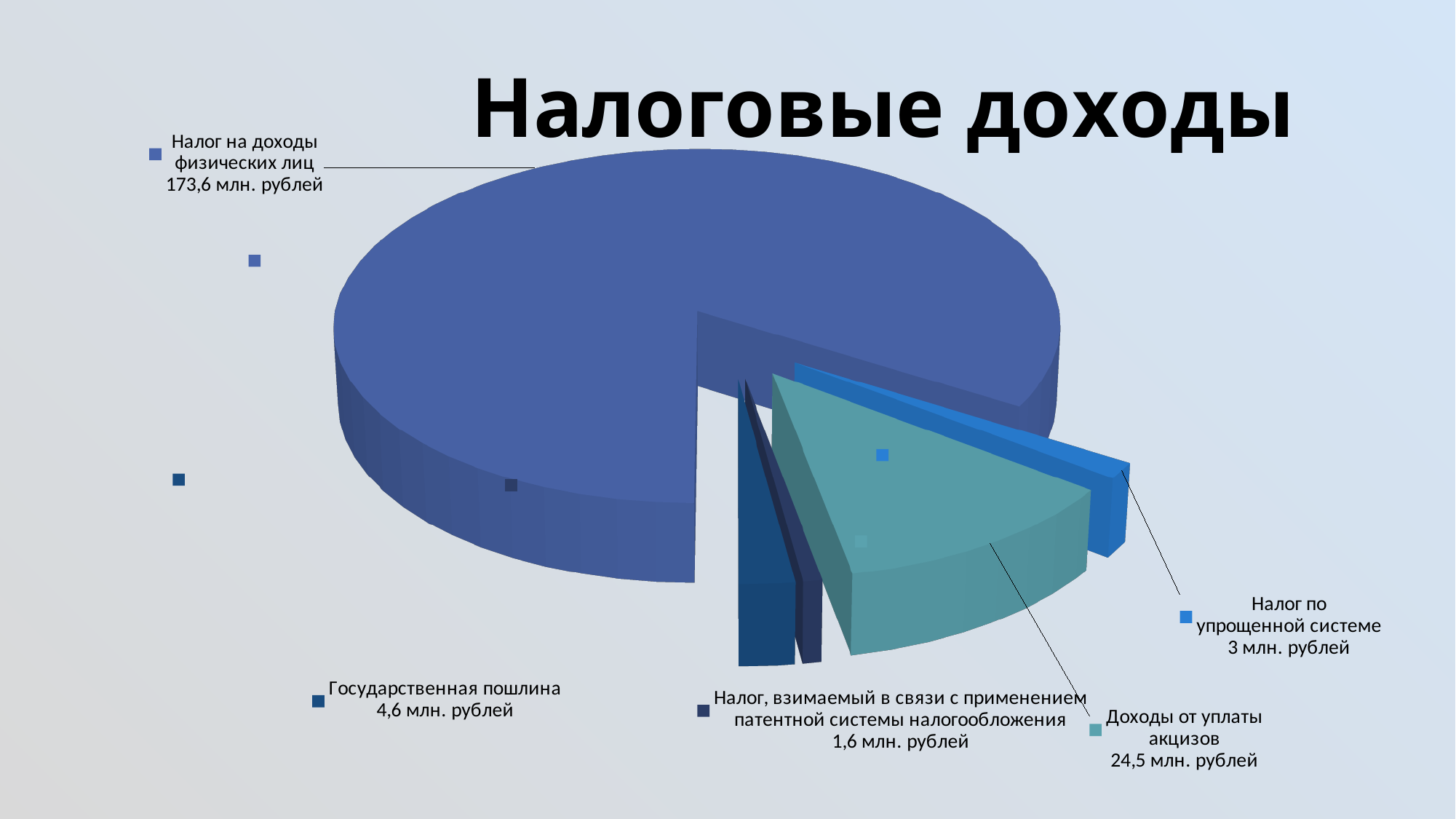
What is the value for Доходы от уплаты акцизов? 24,5 млн. рублей What is the title of the chart? Налоговые доходы How many categories (slices) does the pie chart have? 5 What is the total of all five categories shown in the chart? 207,3 млн. рублей What is the value for Государственная пошлина? 4,6 млн. рублей What is the value for Налог по упрощенной системе? 3 млн. рублей What type of chart is shown on the slide? Pie chart What is the value for Налог на доходы физических лиц? 173,6 млн. рублей Which is larger: Доходы от уплаты акцизов or Государственная пошлина? Доходы от уплаты акцизов Which category has the smallest value? Налог, взимаемый в связи с применением патентной системы налогообложения Which category has the largest value? Налог на доходы физических лиц What is the difference between Налог на доходы физических лиц and Доходы от уплаты акцизов? 149,1 млн. рублей